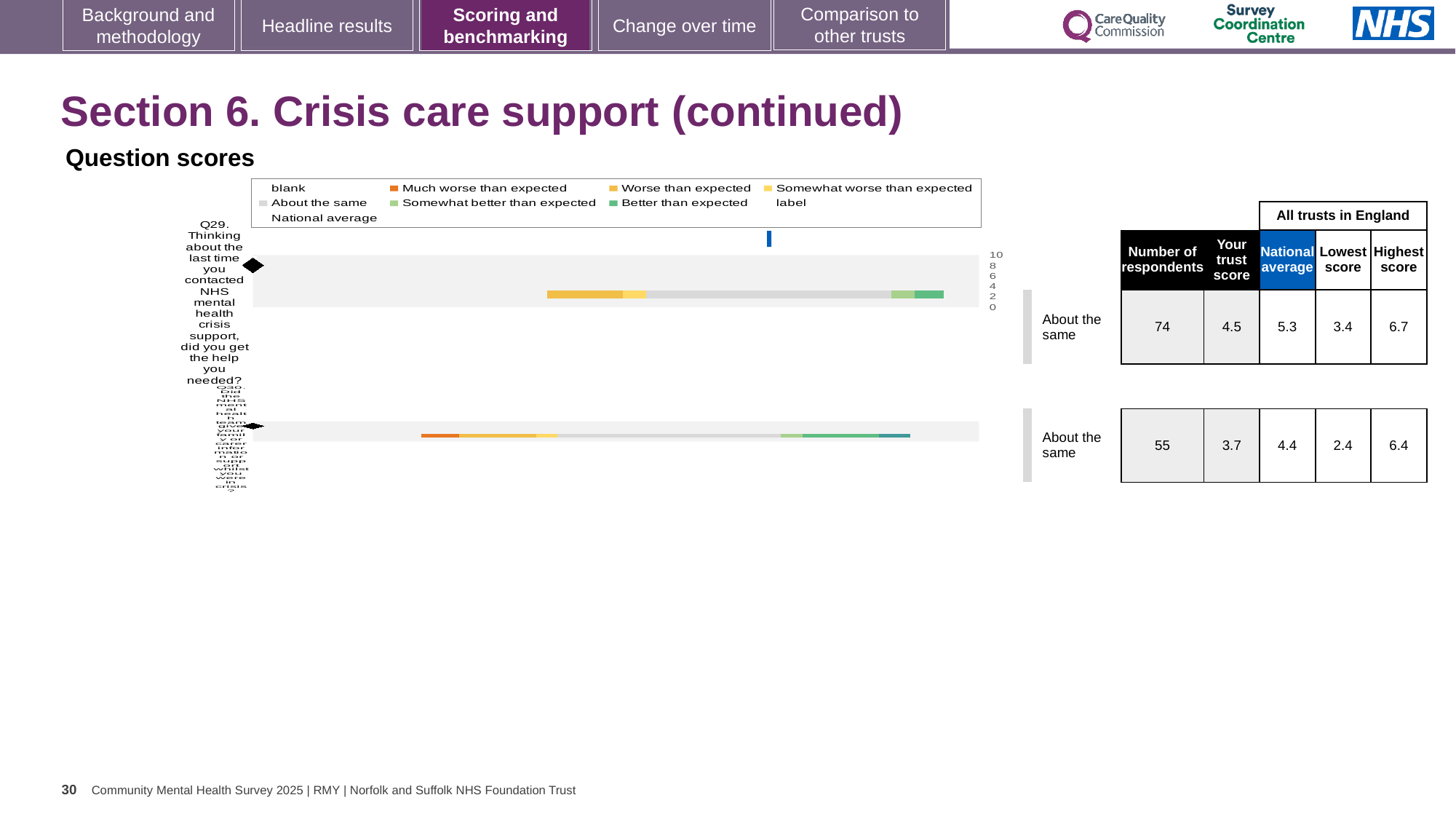
What is the national average for Q29? 5.3 What is the trust score for Q29 (Thinking about the last time you contacted NHS mental health crisis support, did you get the help you needed?)? 4.5 Which question has the higher number of respondents, Q29 or Q30? Q29 What is the highest score among all trusts in England for Q30? 6.4 What benchmark category is shown for both Q29 and Q30? About the same What is the lowest score among all trusts in England for Q30? 2.4 How many respondents answered Q29? 74 For Q30, which is larger: the trust score or the national average? National average How many questions (categories) are plotted in the question scores chart? 2 How many entries does the legend of the question scores chart list? 9 What kind of chart is used to show the question scores on this slide? bar chart What is the difference between the national average and the trust score for Q29? 0.8